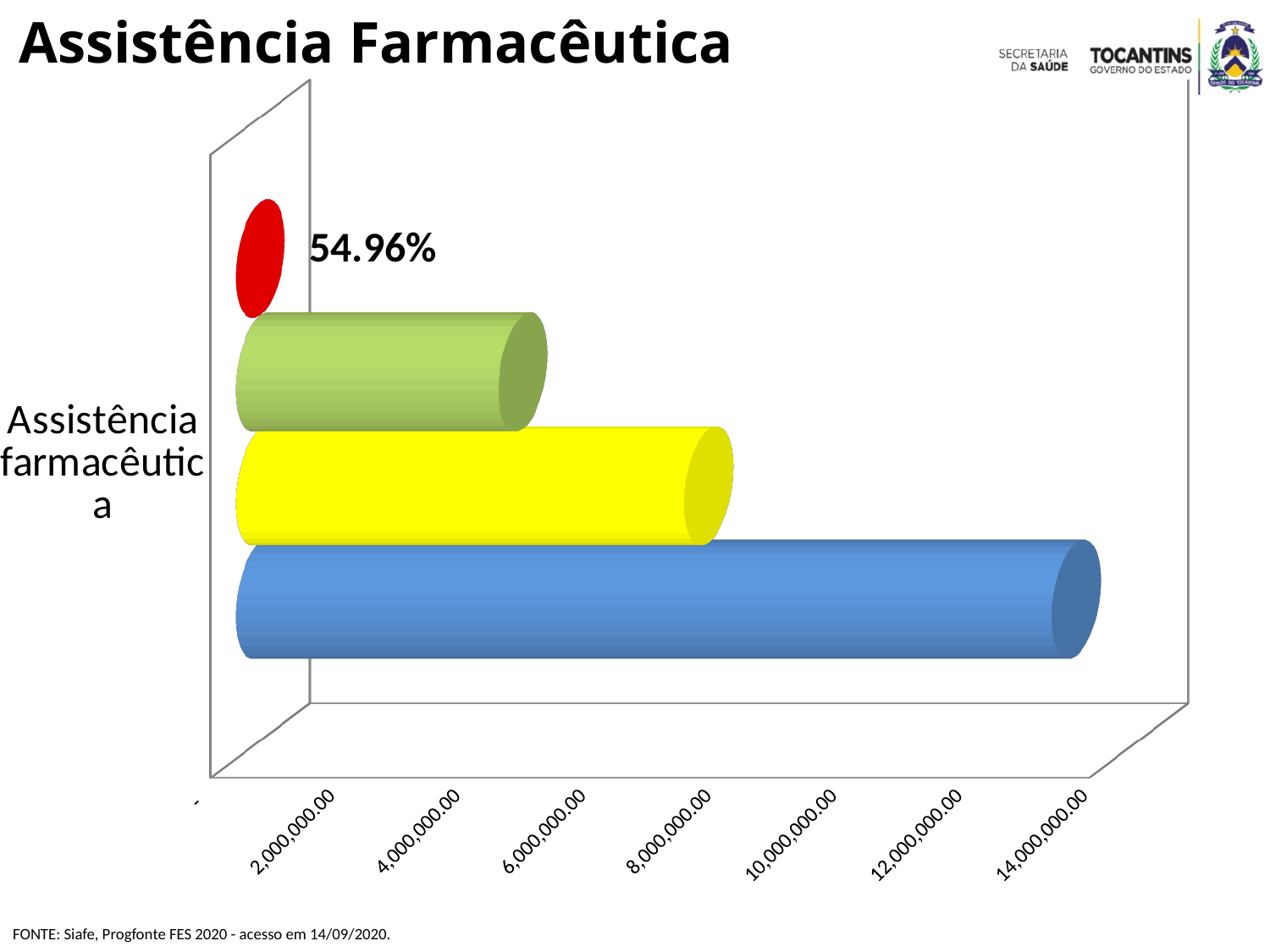
What is the highest tick value shown on the horizontal axis of the chart? 14,000,000.00 Which coloured bar is the longest in the chart? blue How many categories are shown on the vertical axis of the chart? 1 What kind of chart is shown on the slide? bar chart What percentage value is printed next to the red bar in the chart? 54.96% How many bars are plotted in the chart? 4 Which bar is longer, the blue bar or the yellow bar? blue Which coloured bar is the shortest in the chart? red What is the category label shown on the vertical axis of the chart? Assistência farmacêutica Which bar is longer, the green bar or the yellow bar? yellow Is the value of the blue bar greater or less than 12,000,000.00? greater